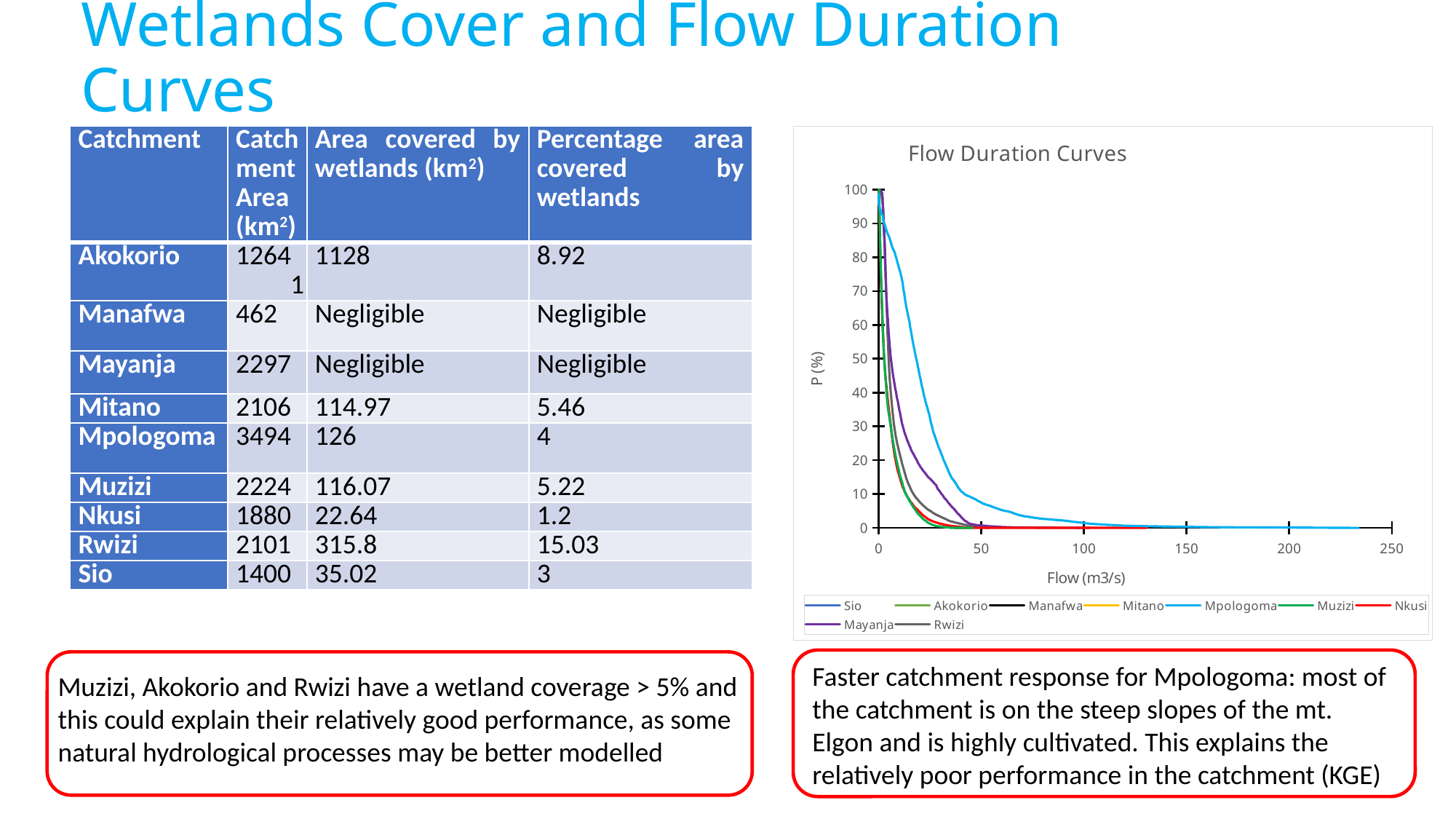
Is the P (%) value for the Mpologoma curve at a flow of 50 m3/s greater or less than 20? less Which series in the chart extends to the highest flow values along the x axis? Mpologoma What is the highest value shown on the x axis of the chart? 250 What is the highest value shown on the y axis of the chart? 100 Is the P (%) value for the Mpologoma curve at a flow of 20 m3/s greater or less than 30? greater What is the label of the x axis of the chart? Flow (m3/s) Do the curves in the chart rise or fall as flow increases along the x axis? fall How many series does the chart legend list? 9 What is the title of the chart? Flow Duration Curves What kind of chart is shown on the slide? line chart At a flow of 20 m3/s, which curve has the higher P (%) value, Mpologoma or Rwizi? Mpologoma